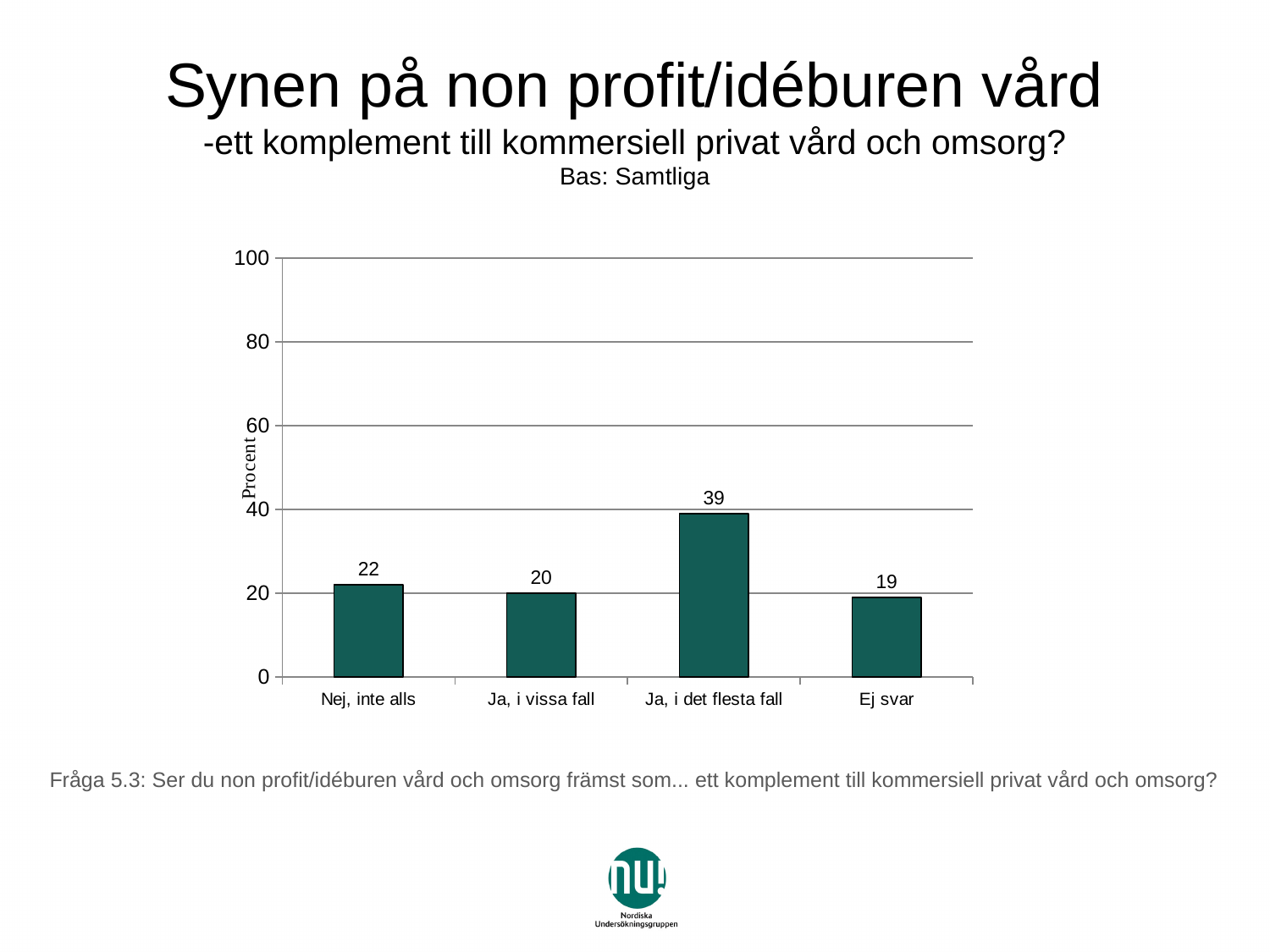
What is the value for "Nej, inte alls"? 22 What kind of chart is shown on the slide? bar chart Which is larger, the value for "Nej, inte alls" or the value for "Ja, i vissa fall"? Nej, inte alls Which category has the highest value? Ja, i det flesta fall What is the highest tick value shown on the y axis? 100 What is the label of the y axis? Procent Is the value for "Ja, i det flesta fall" greater or less than 40? less What is the value for "Ej svar"? 19 How many categories are shown on the x axis? 4 Which category has the lowest value? Ej svar What is the value for "Ja, i det flesta fall"? 39 What is the difference between the values for "Ja, i det flesta fall" and "Ja, i vissa fall"? 19